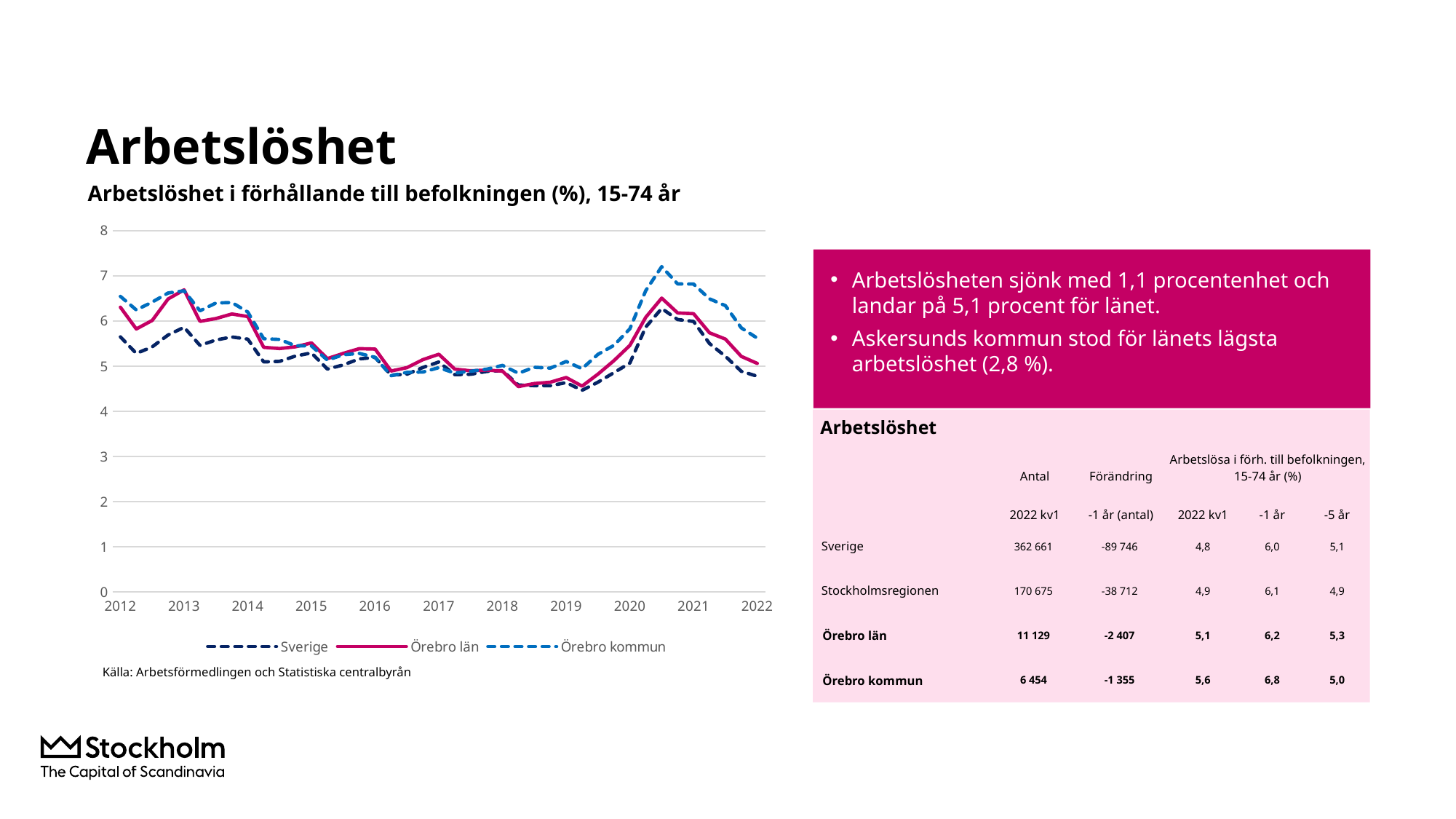
Which series reaches the highest value anywhere on the chart? Örebro kommun Do the values for Örebro län rise or fall from 2021 to 2022? fall How many years are labelled on the x axis of the chart? 11 What kind of chart is shown on the slide? line chart Which series are listed in the chart legend? Sverige, Örebro län, Örebro kommun In 2013, which is higher on the chart, Örebro kommun or Sverige? Örebro kommun Is the value for Örebro kommun in 2022 greater or less than 5? greater Is the value for Sverige in 2019 greater or less than 5? less Which series has the lowest value at the end of the chart in 2022? Sverige What is the title of the chart? Arbetslöshet i förhållande till befolkningen (%), 15-74 år How many series does the chart legend list? 3 Is the value for Örebro kommun at its 2020 peak greater or less than 6? greater